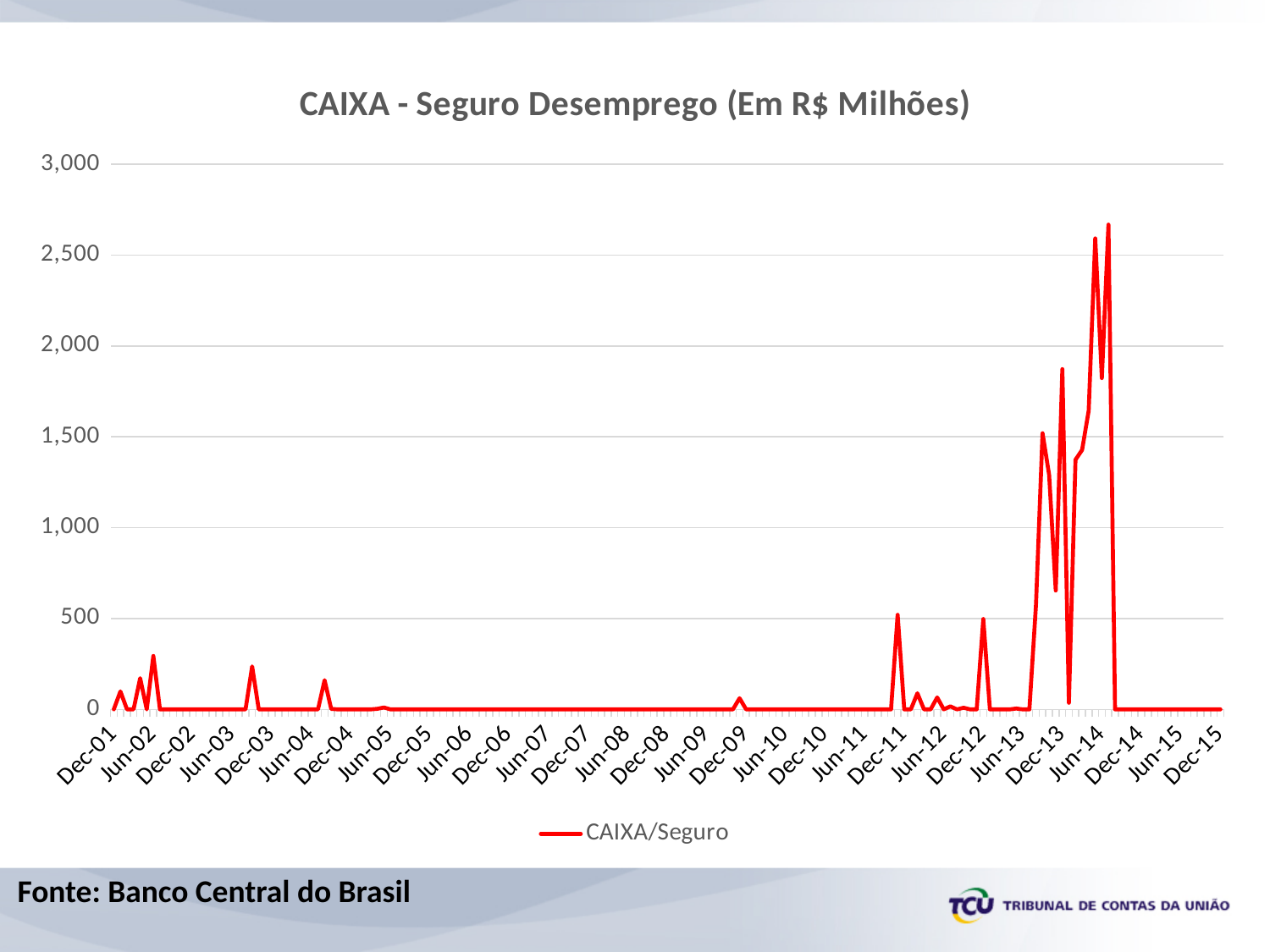
What kind of chart is shown on the slide? line chart Does the CAIXA/Seguro line rise or fall between Jun-14 and Dec-14? fall Is the highest value reached by the CAIXA/Seguro line greater or less than 2,500? greater What is the title of the chart? CAIXA - Seguro Desemprego (Em R$ Milhões) Are the values in 2014 higher or lower than the values in 2007? higher What is the highest value shown on the y axis? 3,000 How many series does the legend list? 1 Is the value for Dec-15 greater or less than 500? less Is the value for Jun-07 greater or less than 500? less How many labels are shown on the x axis? 29 What is the name of the series shown in the legend? CAIXA/Seguro In which year does the CAIXA/Seguro line reach its highest value? 2014